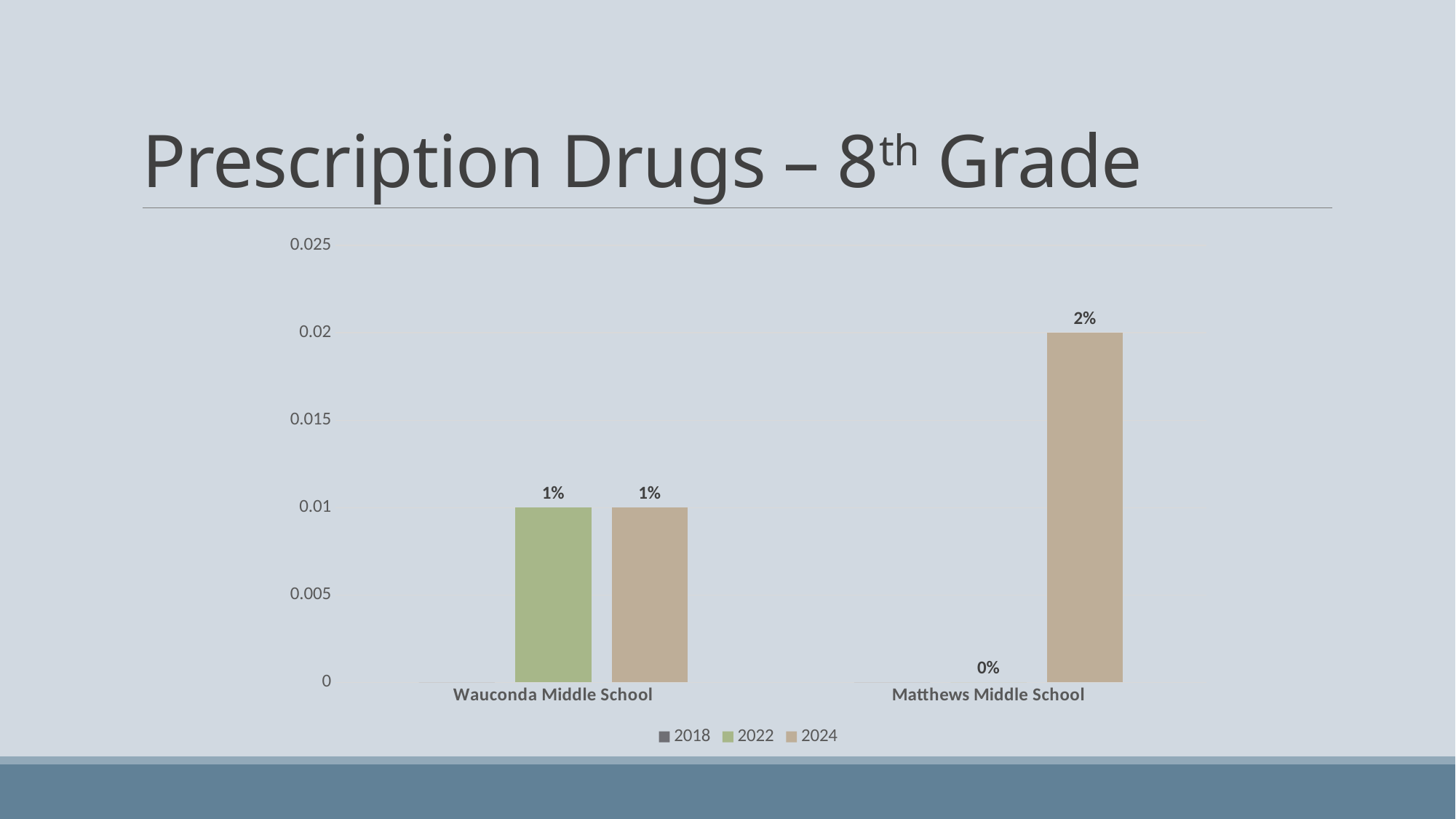
Which bar on the chart is the tallest? Matthews Middle School, 2024 What is the 2024 value for Matthews Middle School? 2% How many series does the legend list? 3 What is the 2022 value for Matthews Middle School? 0% What is the difference between the 2024 values for Matthews Middle School and Wauconda Middle School? 1% How many schools are shown on the x axis? 2 What is the 2024 value for Wauconda Middle School? 1% What kind of chart is shown on the slide? bar chart What is the 2022 value for Wauconda Middle School? 1% Which school has the higher 2024 value? Matthews Middle School What years are listed in the legend? 2018, 2022, 2024 What is the title of the slide? Prescription Drugs – 8th Grade